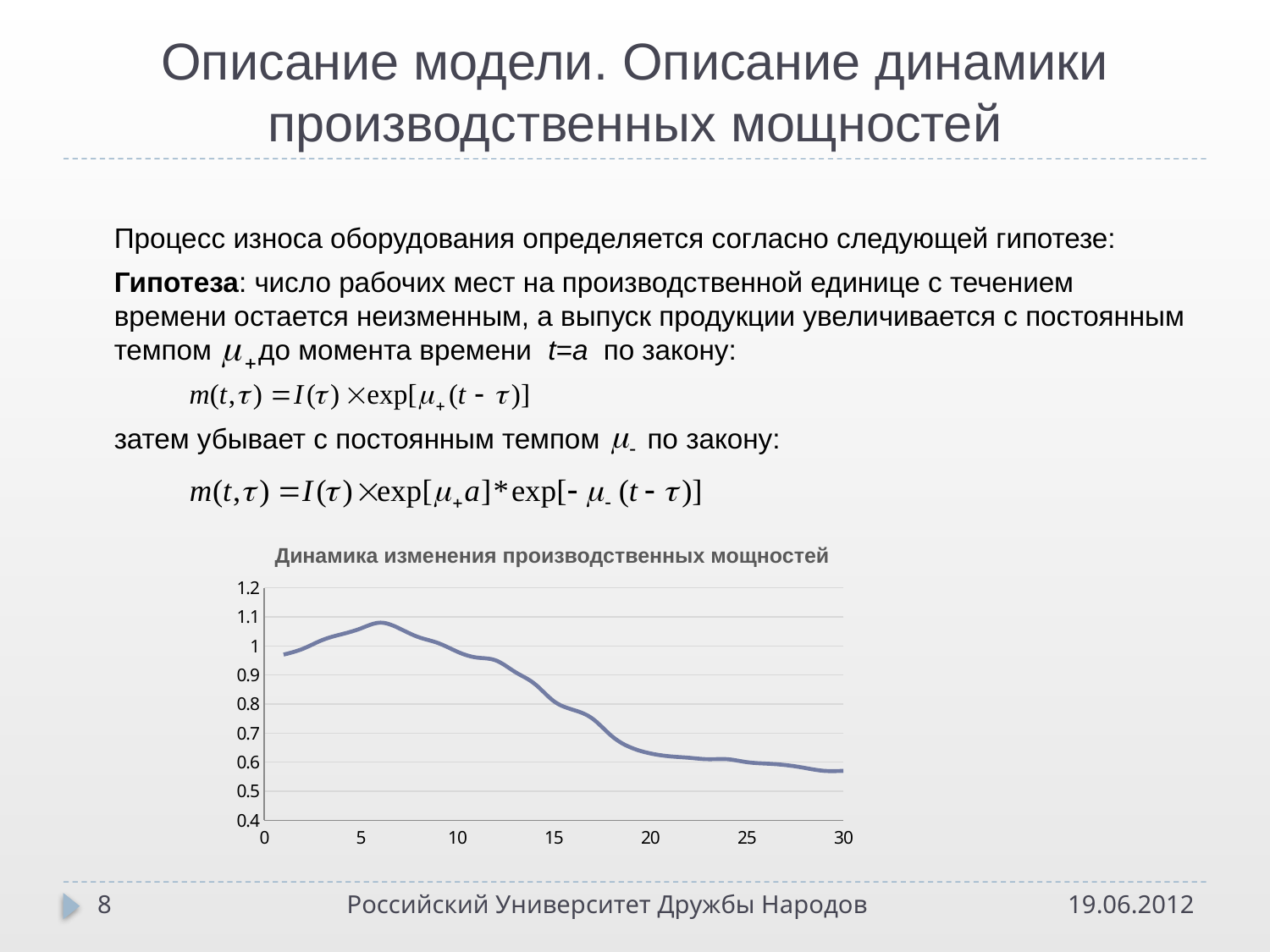
What is the title of the chart? Динамика изменения производственных мощностей Is the value at x = 15 greater or less than 0.9? less Is the value at x = 5 greater or less than 1? greater Is the highest point of the line greater or less than 1.1? less Does the line in the chart rise or fall between x = 10 and x = 30? fall Does the line in the chart rise or fall between x = 0 and x = 5? rise What is the highest value shown on the vertical axis of the chart? 1.2 Which is larger, the value at x = 5 or the value at x = 25? x = 5 What kind of chart is shown on the slide? line chart